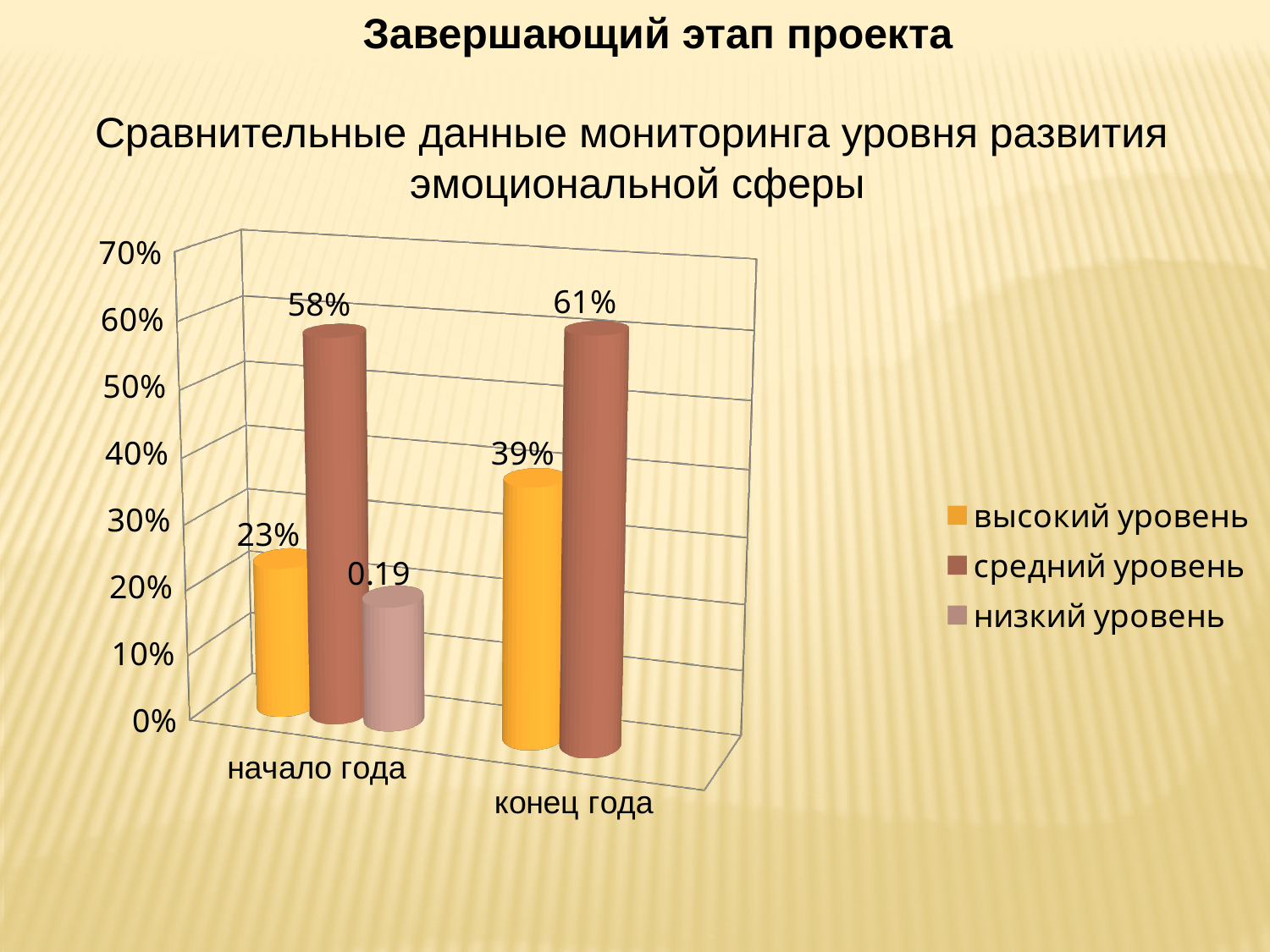
Does the value for высокий уровень rise or fall from начало года to конец года? rise What is the value for высокий уровень at конец года? 39% How many series does the legend list? 3 Which series has the lowest value at начало года? низкий уровень Which is larger: высокий уровень at начало года or высокий уровень at конец года? конец года What is the difference between the средний уровень values at конец года and начало года? 3% What is the difference between the высокий уровень values at конец года and начало года? 16% What is the value for средний уровень at конец года? 61% What is the value for высокий уровень at начало года? 23% What data label is shown for низкий уровень at начало года? 0.19 Which series has the highest value at начало года? средний уровень What kind of chart is shown on the slide? bar chart